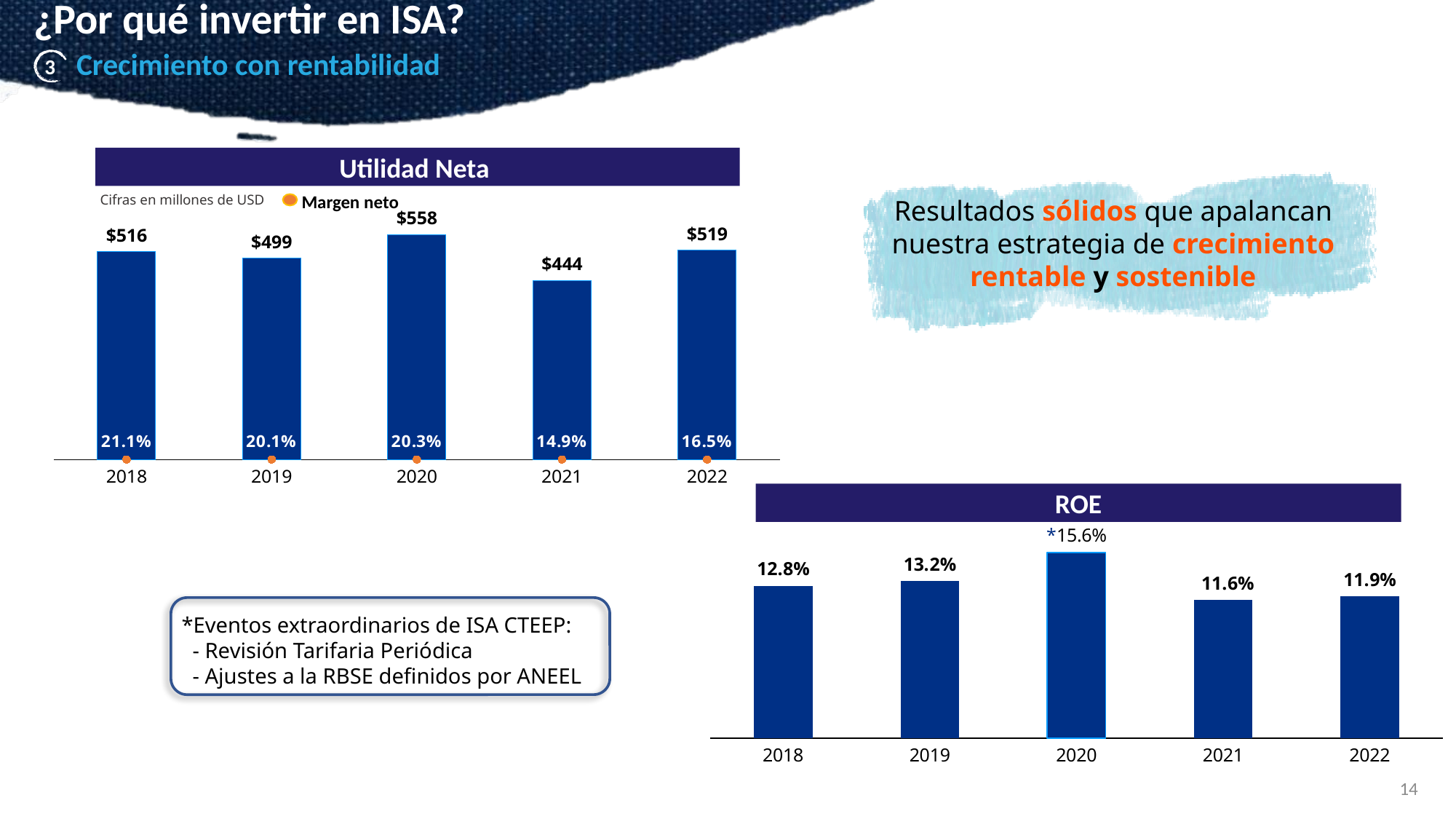
In the ROE chart, which year has the lowest ROE? 2021 In the ROE chart, what is the ROE value for 2019? 13.2% In the Utilidad Neta chart, which year has a higher net income, 2018 or 2022? 2022 In the Utilidad Neta chart, what is the difference between the 2020 and 2021 net income values? $114 In the Utilidad Neta chart, how many years are shown on the x axis? 5 In the ROE chart, what is the difference between the 2018 and 2022 ROE values? 0.9% What kind of chart is the ROE chart? Bar chart In the Utilidad Neta chart, what is the Margen neto for 2021? 14.9% In the Utilidad Neta chart, which year has the highest net income? 2020 In the Utilidad Neta chart, which year has the lowest net income? 2021 In the Utilidad Neta chart, what is the net income value for 2020? $558 In the ROE chart, which year has the highest ROE? 2020